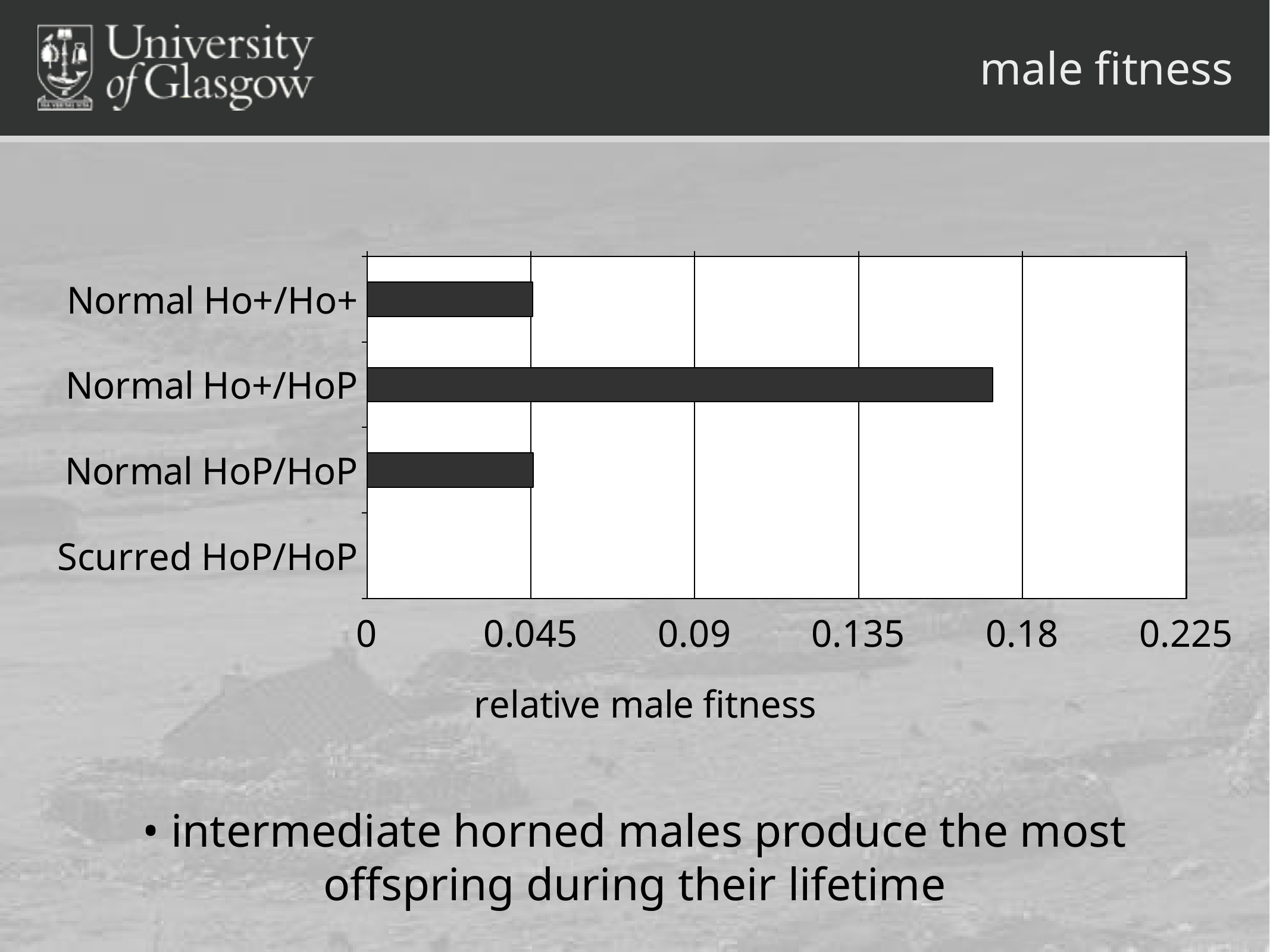
Which is larger, the value for Normal Ho+/HoP or the value for Normal HoP/HoP? Normal Ho+/HoP What is the title shown at the top of the slide? male fitness Which category has the lowest relative male fitness? Scurred HoP/HoP Is the value for Normal Ho+/HoP greater or less than 0.135? greater What kind of chart is shown on the slide? bar chart Is the value for Normal Ho+/HoP greater or less than 0.18? less What is the label of the horizontal axis? relative male fitness What is the relative male fitness for Normal Ho+/Ho+? 0.045 What is the relative male fitness for Scurred HoP/HoP? 0 How many categories are plotted in the chart? 4 Which category has the highest relative male fitness? Normal Ho+/HoP